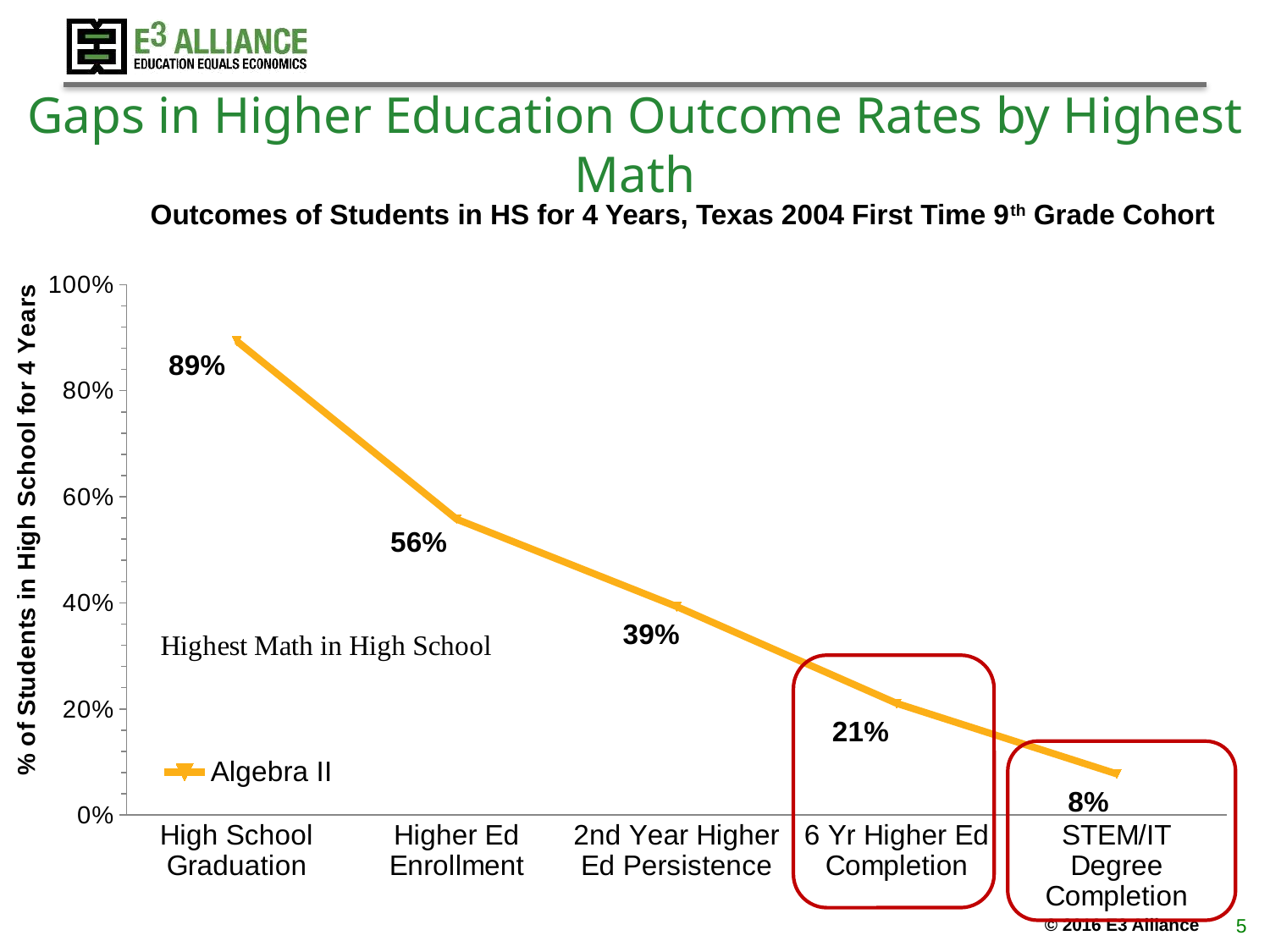
What is the value for 6 Yr Higher Ed Completion? 21% What is the value for High School Graduation for the Algebra II series? 89% What kind of chart is shown on the slide? Line chart Which category has the lowest value? STEM/IT Degree Completion How many categories are shown on the x axis? 5 Do the values rise or fall from left to right along the x axis? Fall What is the value for STEM/IT Degree Completion? 8% What is the value for Higher Ed Enrollment? 56% Which is larger, the value for 2nd Year Higher Ed Persistence or the value for 6 Yr Higher Ed Completion? 2nd Year Higher Ed Persistence Which category has the highest value? High School Graduation What is the value for 2nd Year Higher Ed Persistence? 39% What is the difference between the High School Graduation value and the Higher Ed Enrollment value? 33%